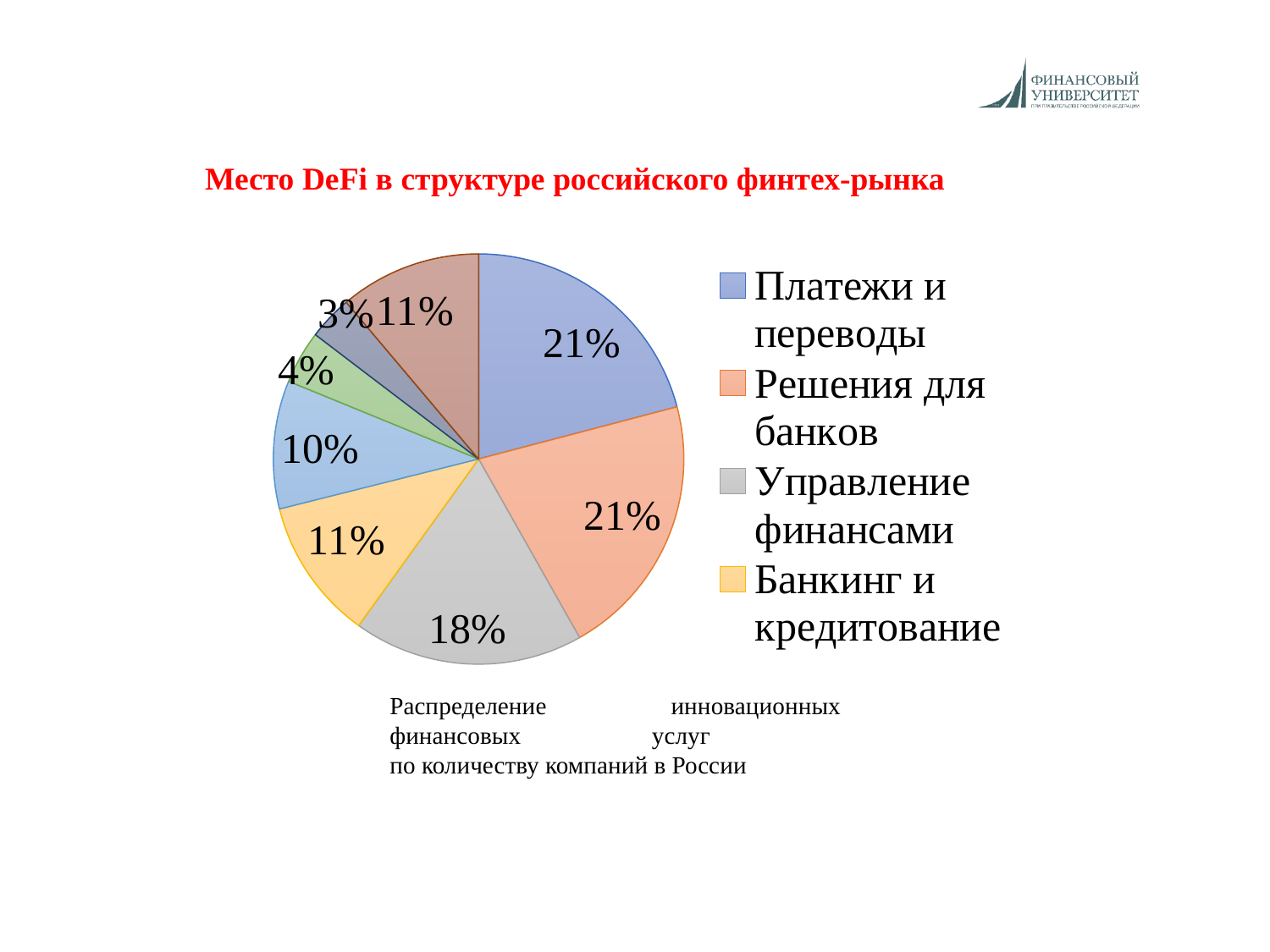
What is the title of the slide above the chart? Место DeFi в структуре российского финтех-рынка What percentage does the slice for Управление финансами show? 18% What percentage does the slice for Решения для банков show? 21% What is the smallest percentage labelled on the pie chart? 3% Which has the larger share: Управление финансами or Банкинг и кредитование? Управление финансами What kind of chart is shown on the slide? Pie chart What percentage does the slice for Банкинг и кредитование show? 11% How many entries does the legend list? 4 What percentage does the slice for Платежи и переводы show? 21% How many slices does the pie chart have? 8 What is the largest percentage labelled on the pie chart? 21% By how many percentage points does Управление финансами exceed Банкинг и кредитование? 7 percentage points